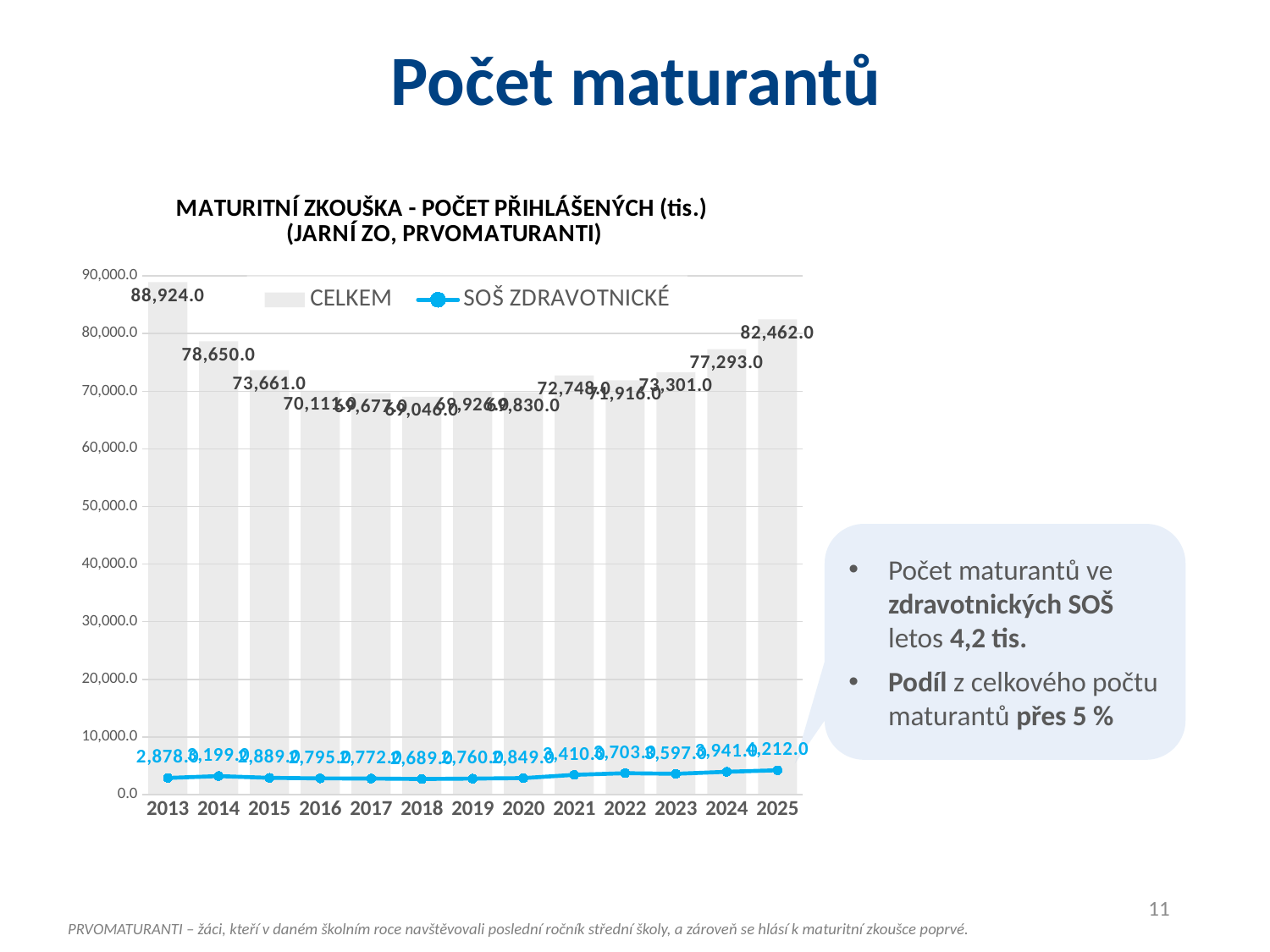
What is the CELKEM value for 2024? 77,293.0 Which year has the highest CELKEM value? 2013 Which year has the highest SOŠ ZDRAVOTNICKÉ value? 2025 How many series does the legend list? 2 What is the SOŠ ZDRAVOTNICKÉ value for 2025? 4,212.0 What is the CELKEM value for 2013? 88,924.0 Which is larger, the CELKEM value for 2014 or for 2015? 2014 How many years are shown on the x axis? 13 What is the CELKEM value for 2025? 82,462.0 Is the CELKEM value for 2015 greater or less than 70,000.0? greater Does the CELKEM value rise or fall from 2013 to 2018? fall What is the difference between the CELKEM values for 2013 and 2025? 6,462.0